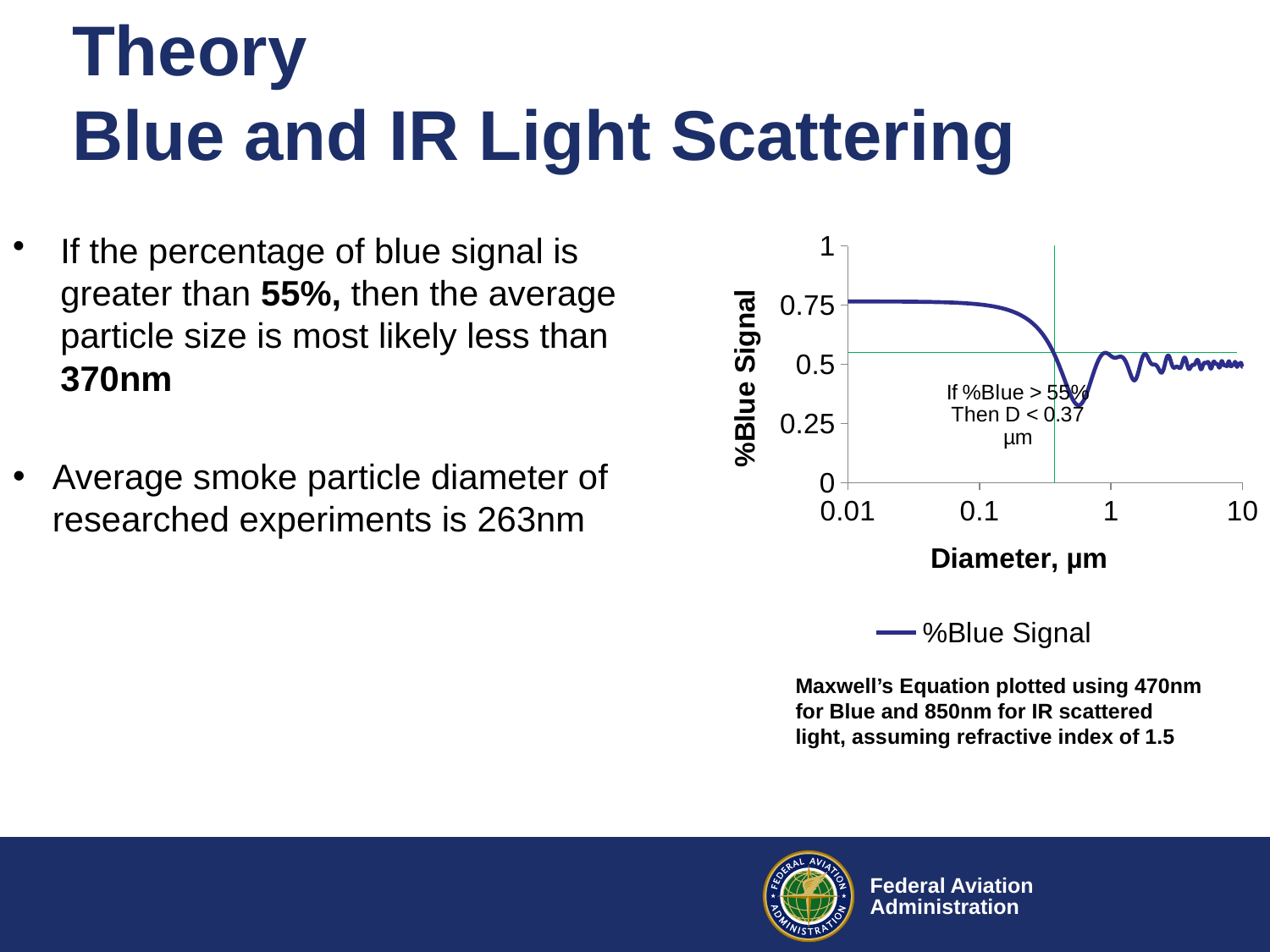
Which is larger: the %Blue Signal at a diameter of 0.01 µm or at a diameter of 0.5 µm? 0.01 µm What is the largest diameter value shown on the chart's x axis? 10 Is the value of %Blue Signal at a diameter of 0.01 µm greater or less than 1? less What kind of chart is shown on the slide? line chart Does the %Blue Signal curve rise or fall as the diameter increases from 0.01 µm to about 0.5 µm? fall How many series does the chart legend list? 1 What is the name of the series listed in the chart legend? %Blue Signal Is the value of %Blue Signal at a diameter of 0.01 µm greater or less than 0.5? greater What is the highest value shown on the chart's y axis? 1 Is the lowest point of the %Blue Signal curve (the dip just below 1 µm) greater or less than 0.5? less